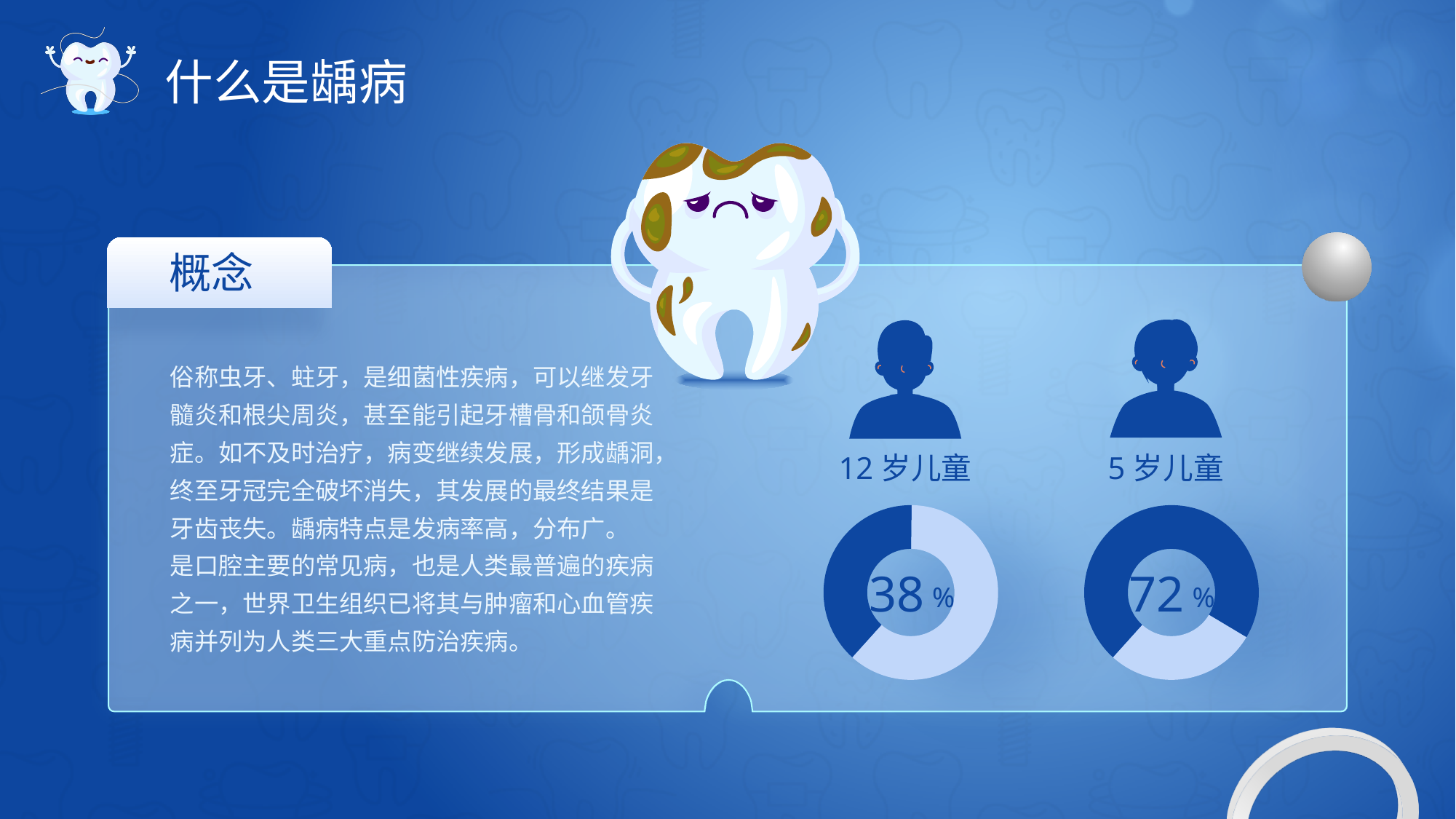
What label appears above the donut chart on the right side of the slide? 5 岁儿童 In the donut chart for 12 岁儿童, is the dark blue portion greater or less than 50%? less How many donut charts are shown on the slide? 2 What is the difference between the percentage for 5 岁儿童 and the percentage for 12 岁儿童? 34% What value is shown in the centre of the donut chart for 12 岁儿童? 38% What kind of chart is used to show the percentage for 12 岁儿童? Donut (pie) chart Which group has the higher percentage, 12 岁儿童 or 5 岁儿童? 5 岁儿童 In the donut chart for 5 岁儿童, is the dark blue portion greater or less than 50%? greater What value is shown in the centre of the donut chart for 5 岁儿童? 72% What label appears above the donut chart on the left of the two charts? 12 岁儿童 Which group has the lower percentage, 12 岁儿童 or 5 岁儿童? 12 岁儿童